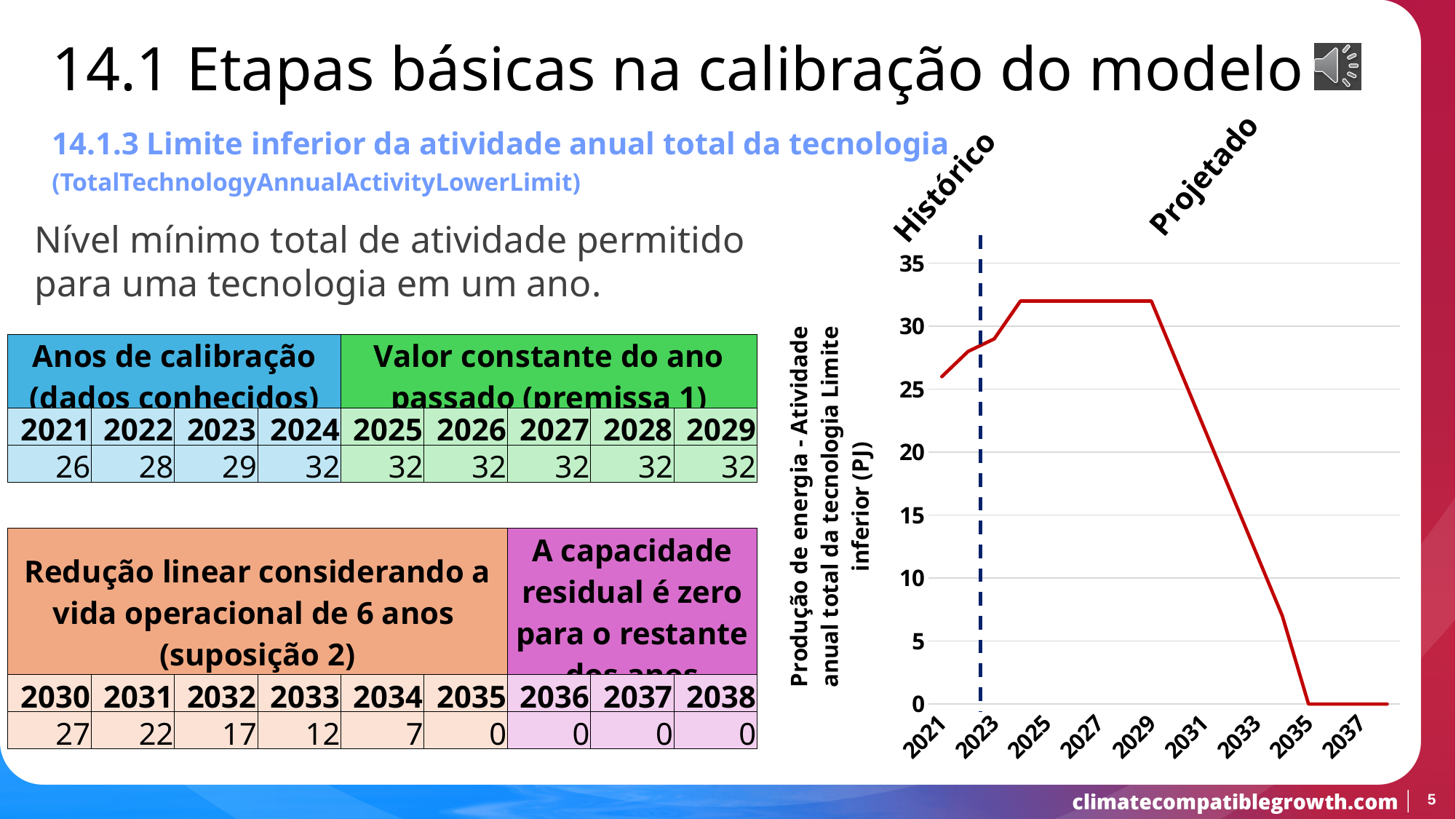
In the line chart, is the value for 2027 greater or less than 30? greater How many year labels are shown on the x axis of the line chart? 9 In the line chart, which is larger, the value for 2025 or the value for 2031? 2025 What two labels mark the regions on either side of the dashed vertical line in the chart? Histórico and Projetado In the line chart, is the value for 2033 greater or less than 15? less In the line chart, is the value for 2031 greater or less than 20? greater What kind of chart is shown on the right of the slide? line chart What is the y-axis title of the line chart? Produção de energia - Atividade anual total da tecnologia Limite inferior (PJ) In the line chart, do the values rise or fall along the x axis between 2029 and 2035? fall In the line chart, which is larger, the value for 2021 or the value for 2035? 2021 In the line chart, what is the value for 2037? 0